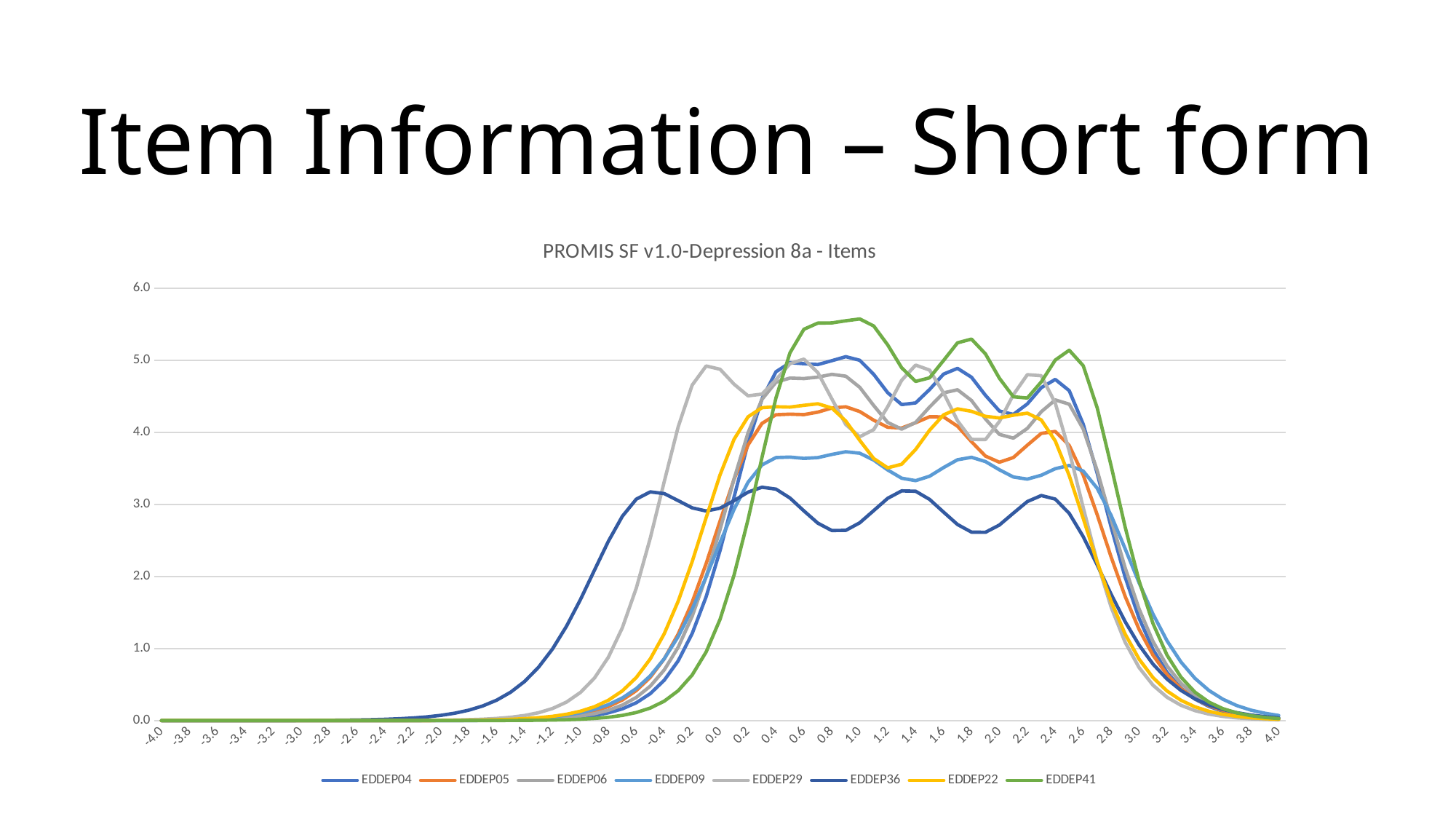
What is the value for EDDEP41 at x = -4.0? 0.0 Which series has the lowest value at x = 1.0? EDDEP36 What is the title of the chart? PROMIS SF v1.0-Depression 8a - Items At x = 0.0, which series has the larger value, EDDEP29 or EDDEP36? EDDEP29 Does the value for EDDEP41 rise or fall between x = 2.6 and x = 4.0? fall What kind of chart is shown on the slide? line chart Which series reaches the highest value on the chart? EDDEP41 Is the value for EDDEP36 at x = -0.6 greater or less than 2.0? greater Is the value for EDDEP36 at x = 0.8 greater or less than 3.0? less Is the value for EDDEP41 at x = 1.0 greater or less than 5.0? greater How many series does the legend list? 8